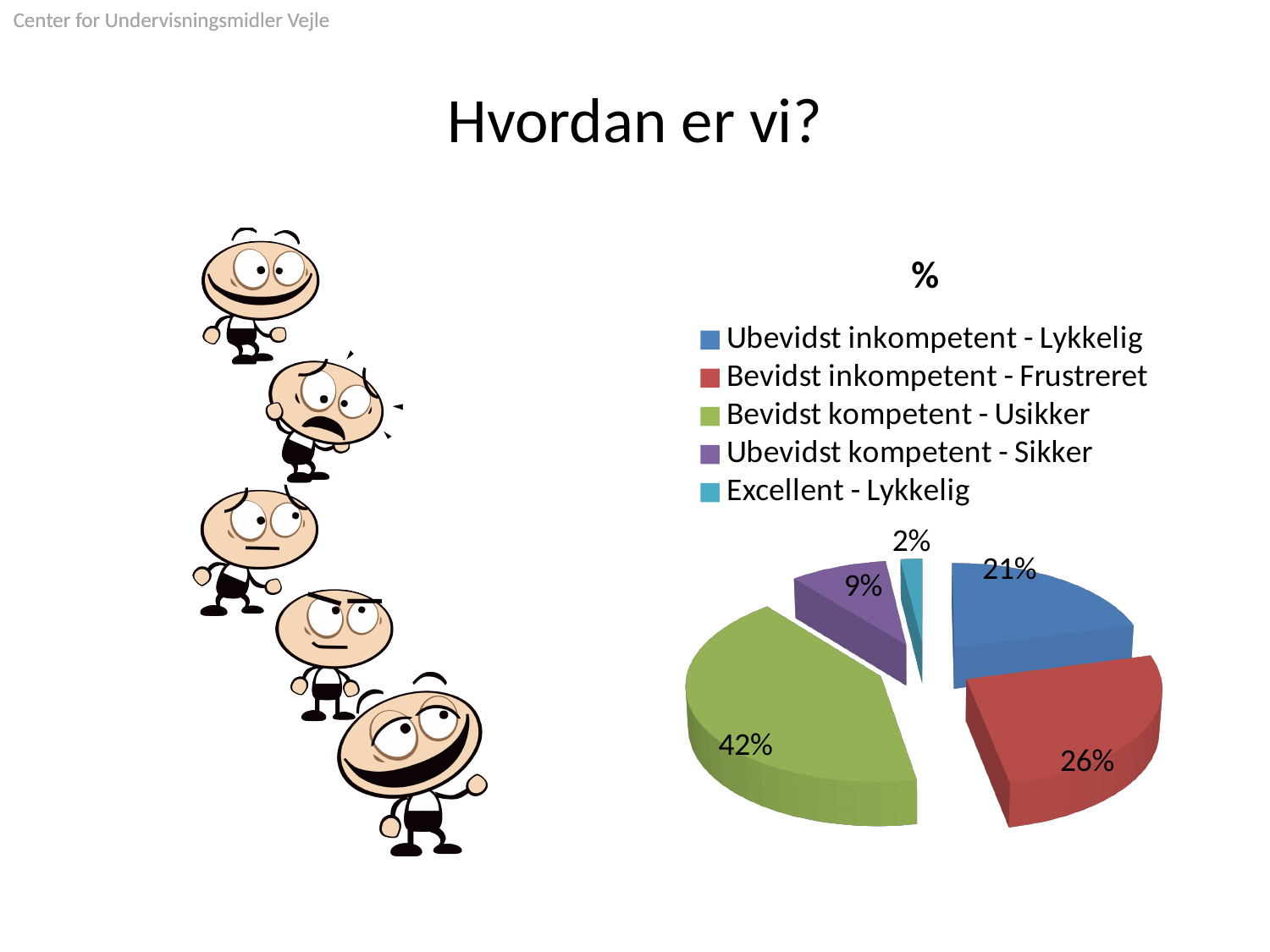
What share of the pie is labelled for Excellent - Lykkelig? 2% What is the title of the chart? % What share of the pie is labelled for Bevidst inkompetent - Frustreret? 26% Which is larger, the slice for Bevidst inkompetent - Frustreret or the slice for Ubevidst inkompetent - Lykkelig? Bevidst inkompetent - Frustreret Which category has the smallest slice of the pie? Excellent - Lykkelig What share of the pie is labelled for Ubevidst inkompetent - Lykkelig? 21% What is the difference in percentage points between Bevidst kompetent - Usikker and Bevidst inkompetent - Frustreret? 16 What type of chart is shown on the slide? pie chart How many categories does the legend list? 5 Which category has the largest slice of the pie? Bevidst kompetent - Usikker